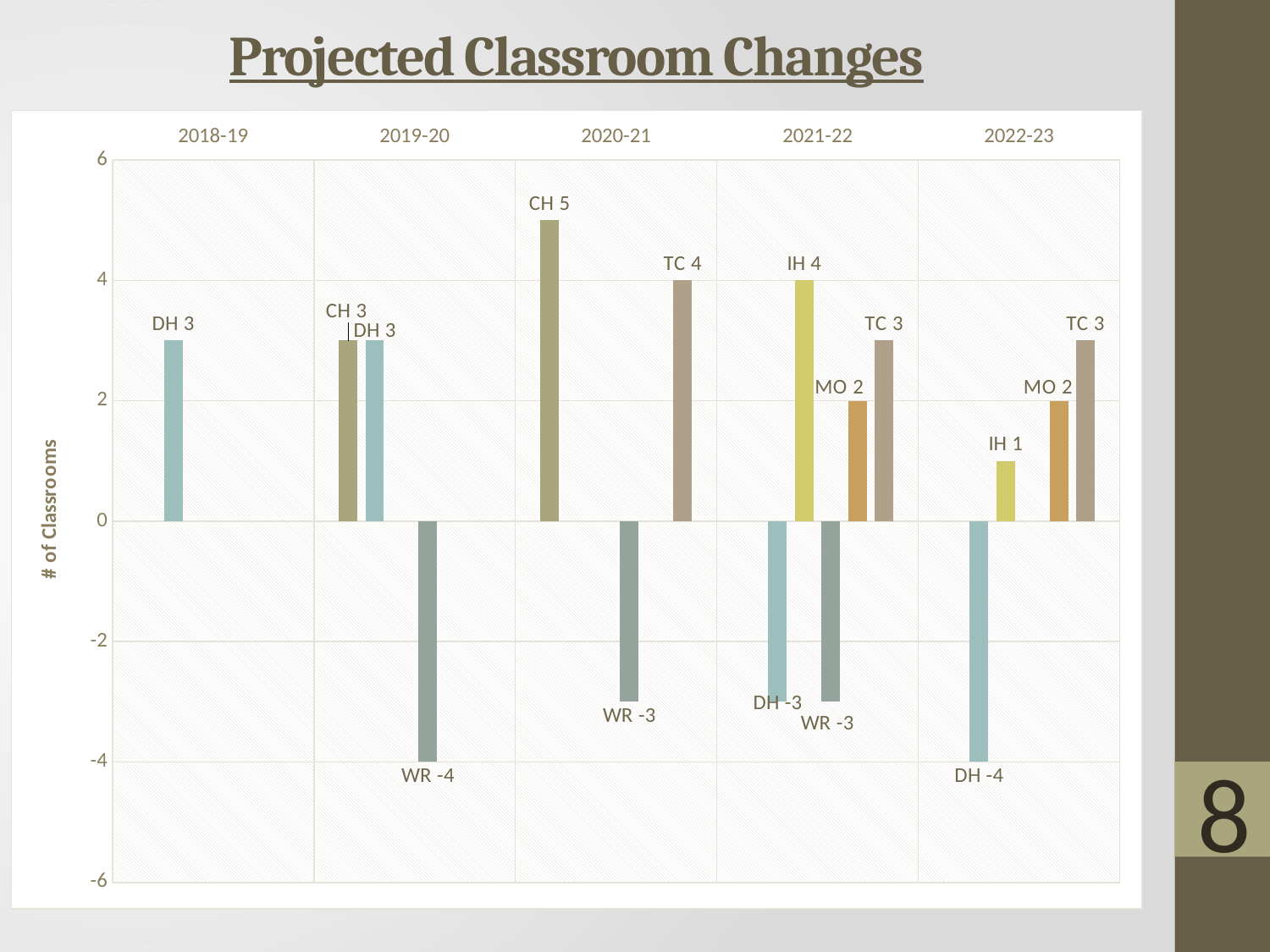
What is the value for IH in 2022-23? 1 What is the difference between the CH value in 2020-21 and the TC value in 2020-21? 1 Which school has the highest value in 2021-22? IH What is the value for CH in 2020-21? 5 What is the value for DH in 2022-23? -4 What is the value for TC in 2020-21? 4 What is the value for WR in 2019-20? -4 How many school years are shown along the x axis? 5 Which labelled bar has the highest value on the chart? CH 5 (2020-21) What kind of chart is shown on the slide? Bar chart What is the label of the vertical axis? # of Classrooms Which is larger, the IH value in 2021-22 or the IH value in 2022-23? IH in 2021-22